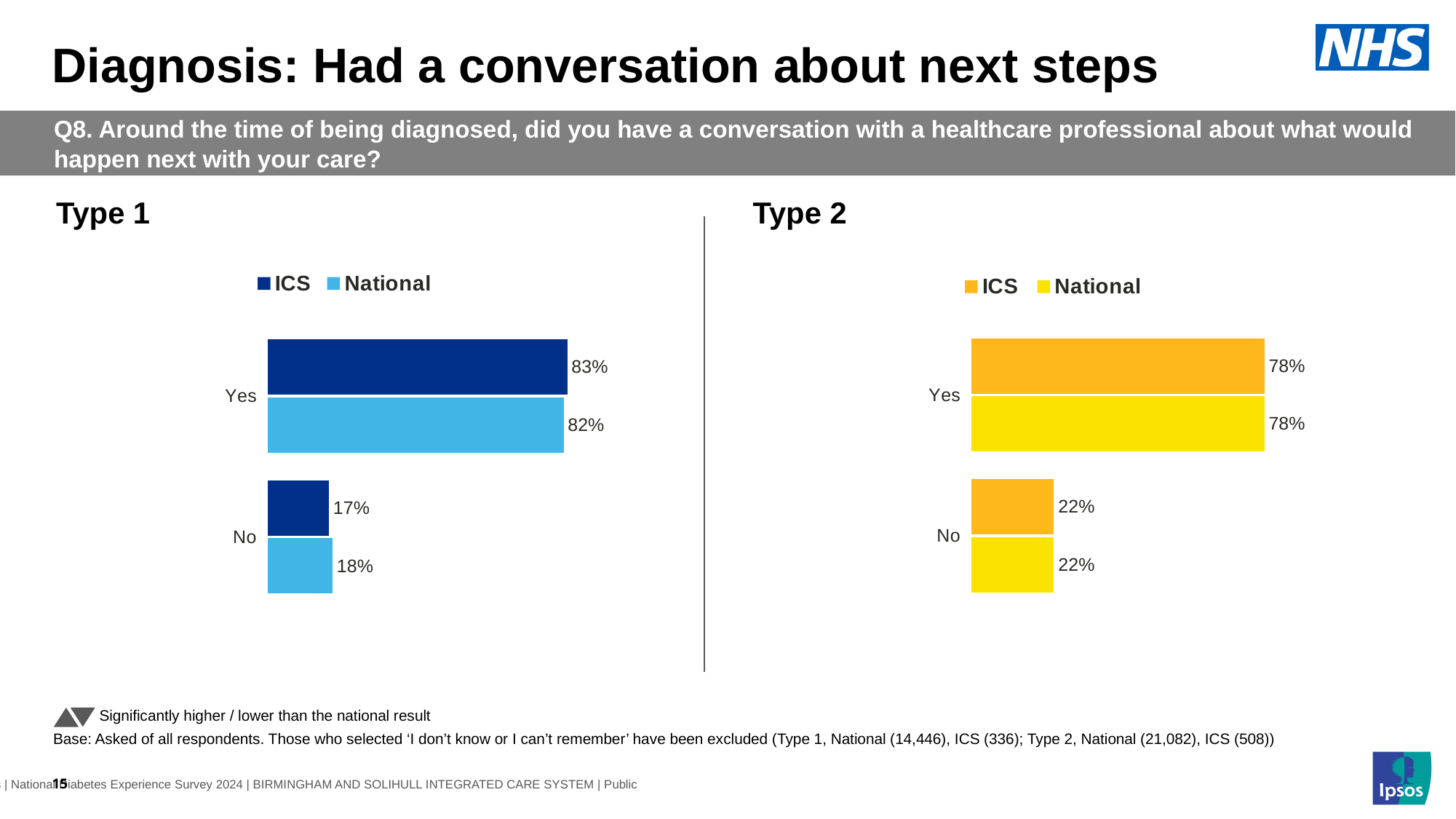
In the Type 2 chart, what is the National value for No? 22% In the Type 1 chart, what is the ICS value for Yes? 83% In the Type 1 chart, what is the difference between the ICS and National values for Yes? 1% In the Type 2 chart, what is the difference between the ICS values for Yes and No? 56% In the Type 2 chart, what is the ICS value for Yes? 78% How many categories are shown in the Type 1 chart? 2 In the Type 1 chart, is the ICS value for No larger or smaller than the National value for No? smaller In the Type 1 chart, what is the National value for No? 18% In the Type 1 chart, which category has the highest ICS value? Yes In the Type 2 chart, which category has the lowest National value? No How many series does the legend of the Type 2 chart list? 2 What kind of chart is the Type 2 chart? bar chart